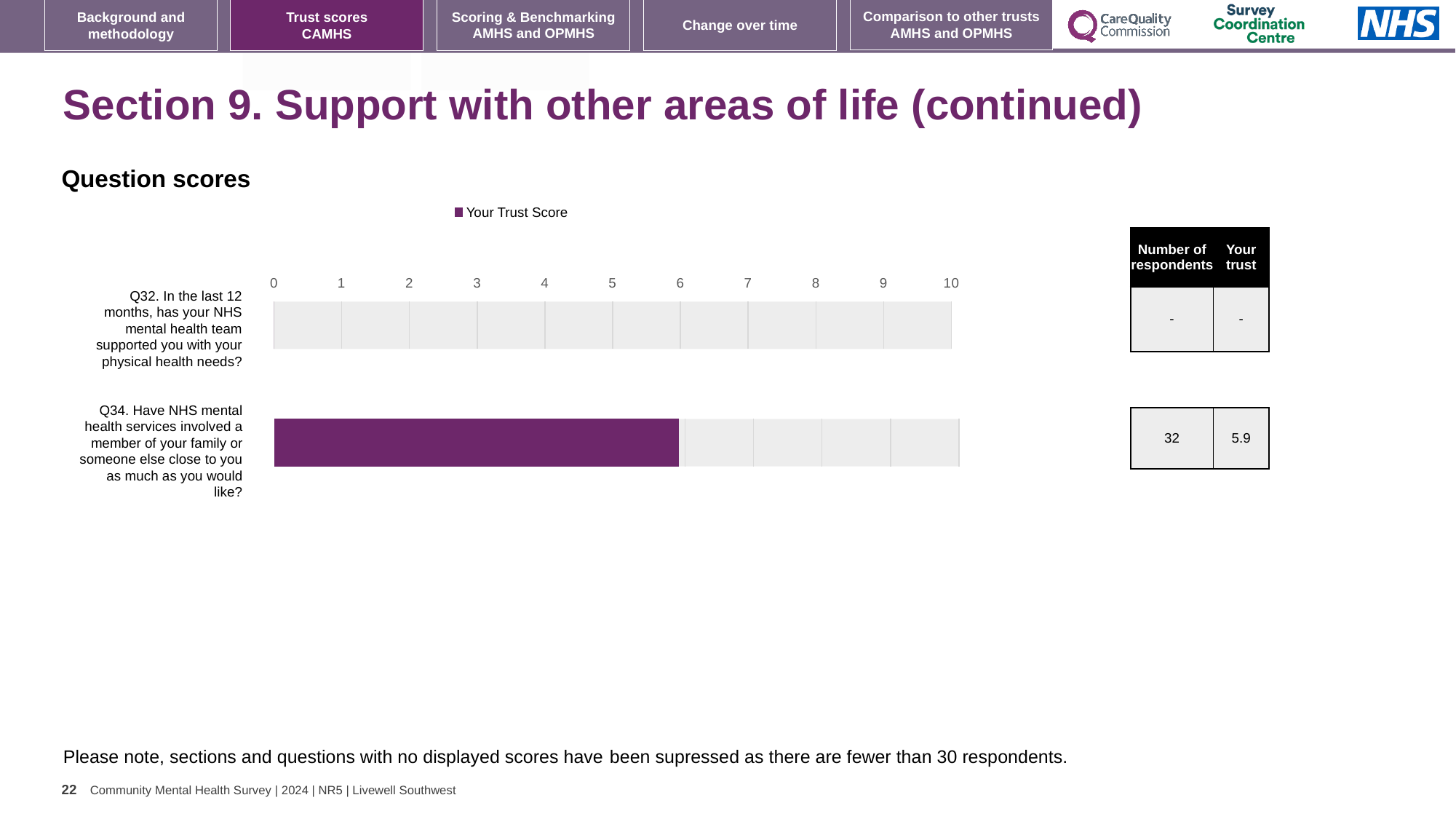
What is the maximum value shown on the chart's x axis? 10 What is shown as the trust score for Q32 (support with physical health needs)? - What is the name of the series shown in the chart legend? Your Trust Score How many series does the chart legend list? 1 What is the trust score for Q34 (involving a family member or someone close as much as you would like)? 5.9 How many respondents answered Q34? 32 Is the trust score for Q34 greater or less than 7? less Which question has a plotted bar on the chart, Q32 or Q34? Q34 What is shown as the number of respondents for Q32? - How many questions (categories) are listed on the chart? 2 What kind of chart is shown on the slide? bar chart Is the trust score for Q34 greater or less than 5? greater